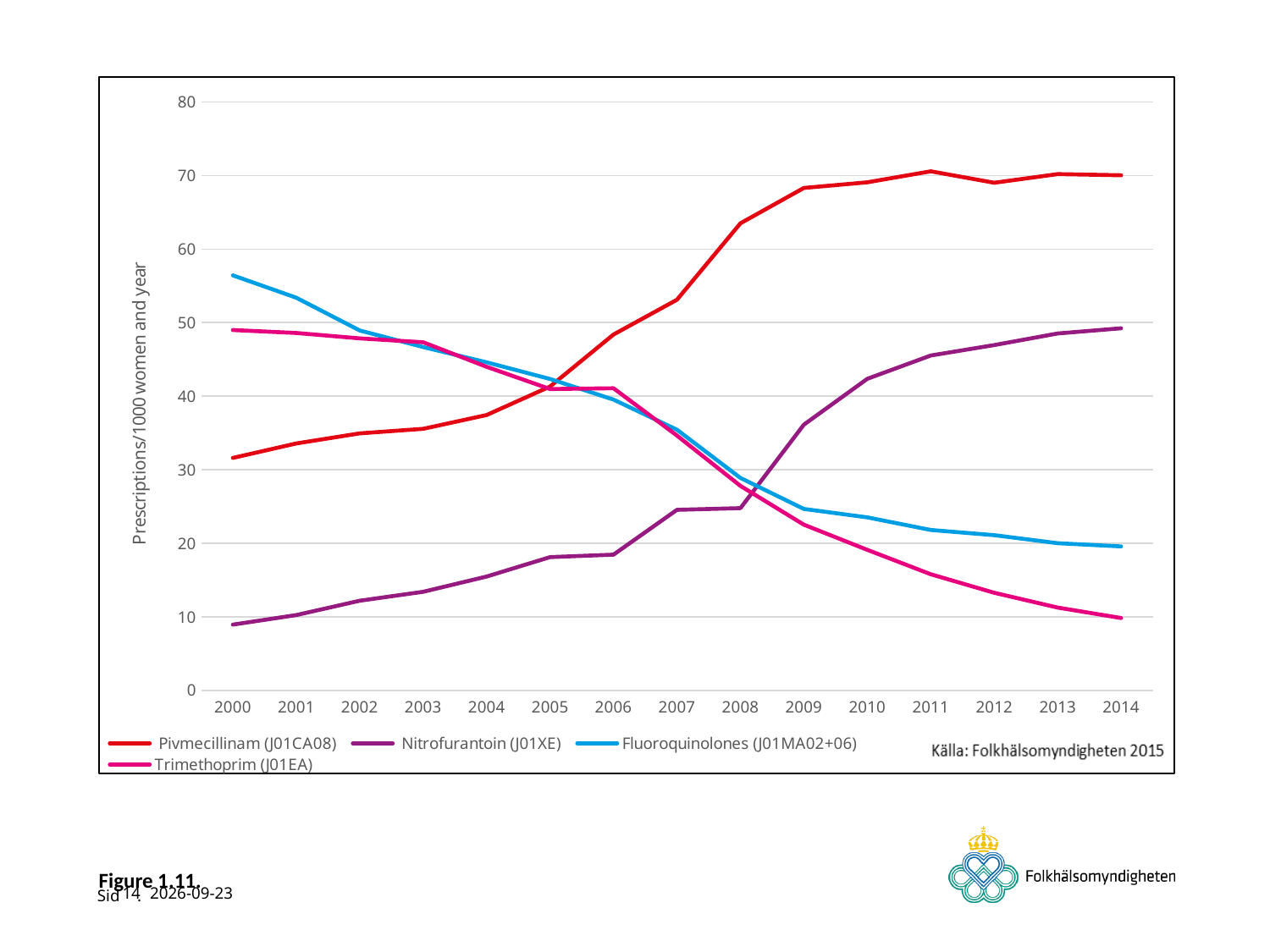
Which series has the lowest value in 2014? Trimethoprim (J01EA) Is the value for Fluoroquinolones (J01MA02+06) in 2000 greater or less than 50? greater How many years are shown along the x axis? 15 In 2000, which is larger: Fluoroquinolones (J01MA02+06) or Pivmecillinam (J01CA08)? Fluoroquinolones (J01MA02+06) Does the Trimethoprim (J01EA) line rise or fall from 2000 to 2014? Fall How many series does the legend list? 4 Which series has the lowest value in 2000? Nitrofurantoin (J01XE) Does the Pivmecillinam (J01CA08) line rise or fall from 2000 to 2014? Rise What kind of chart is shown on the slide? Line chart Which series has the highest value in 2014? Pivmecillinam (J01CA08) Is the value for Trimethoprim (J01EA) in 2011 greater or less than 20? less What is the label of the y axis? Prescriptions/1000 women and year